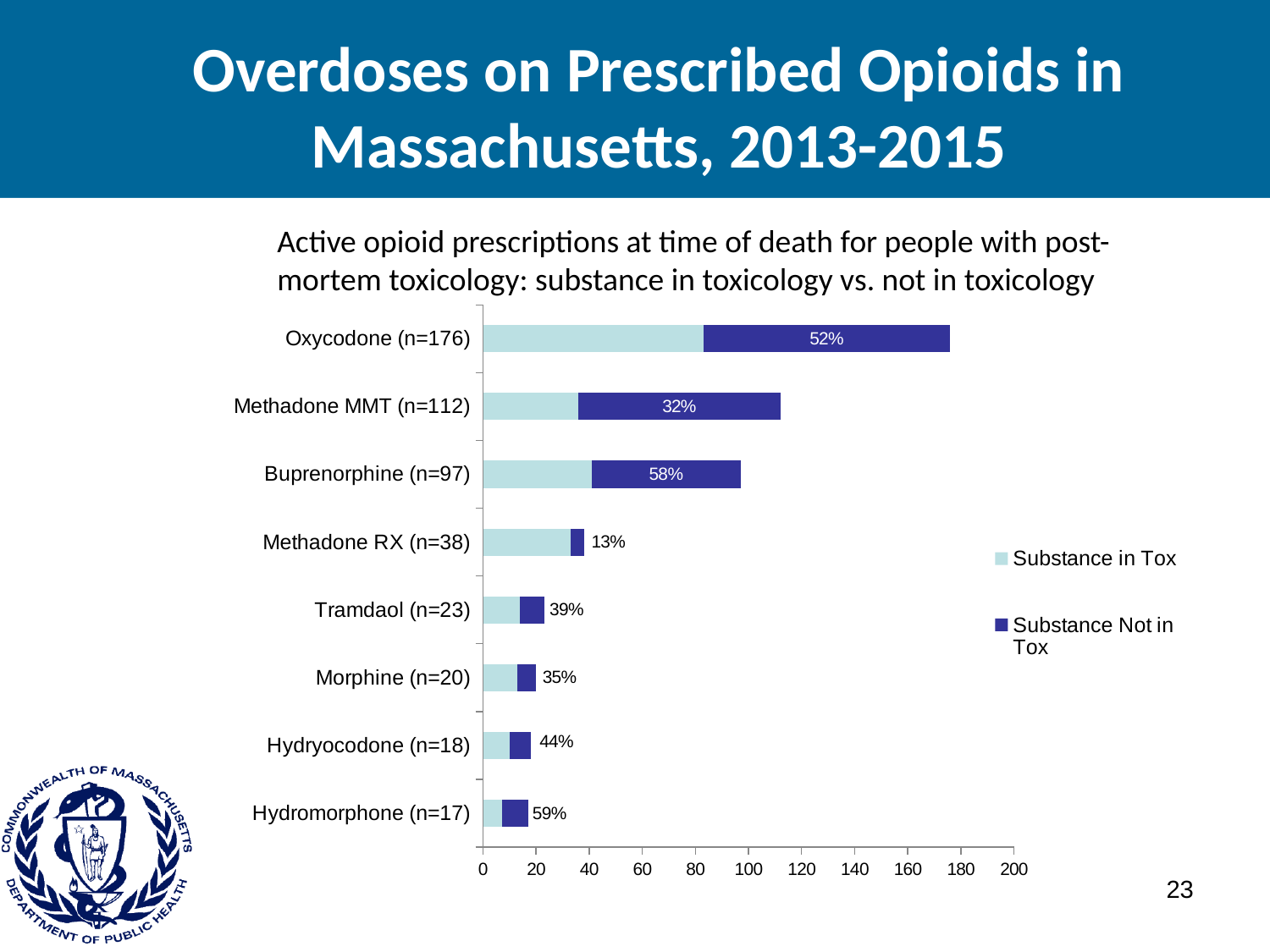
How many series does the legend list? 2 Which category has the longest total bar? Oxycodone (n=176) Which category has the shortest total bar? Hydromorphone (n=17) Which has the longer total bar, Methadone MMT (n=112) or Buprenorphine (n=97)? Methadone MMT (n=112) What are the two legend entries on the chart? Substance in Tox; Substance Not in Tox What kind of chart is shown on the slide? Stacked bar chart What is the difference between the percentage labels for Hydromorphone (n=17) and Methadone RX (n=38)? 46 percentage points What percentage label is shown on the Methadone RX (n=38) bar? 13% What percentage label is shown on the Hydromorphone (n=17) bar? 59% How many categories are plotted on the chart? 8 What percentage label is shown on the Oxycodone (n=176) bar? 52% Is the total bar length for Buprenorphine (n=97) greater or less than 100? less